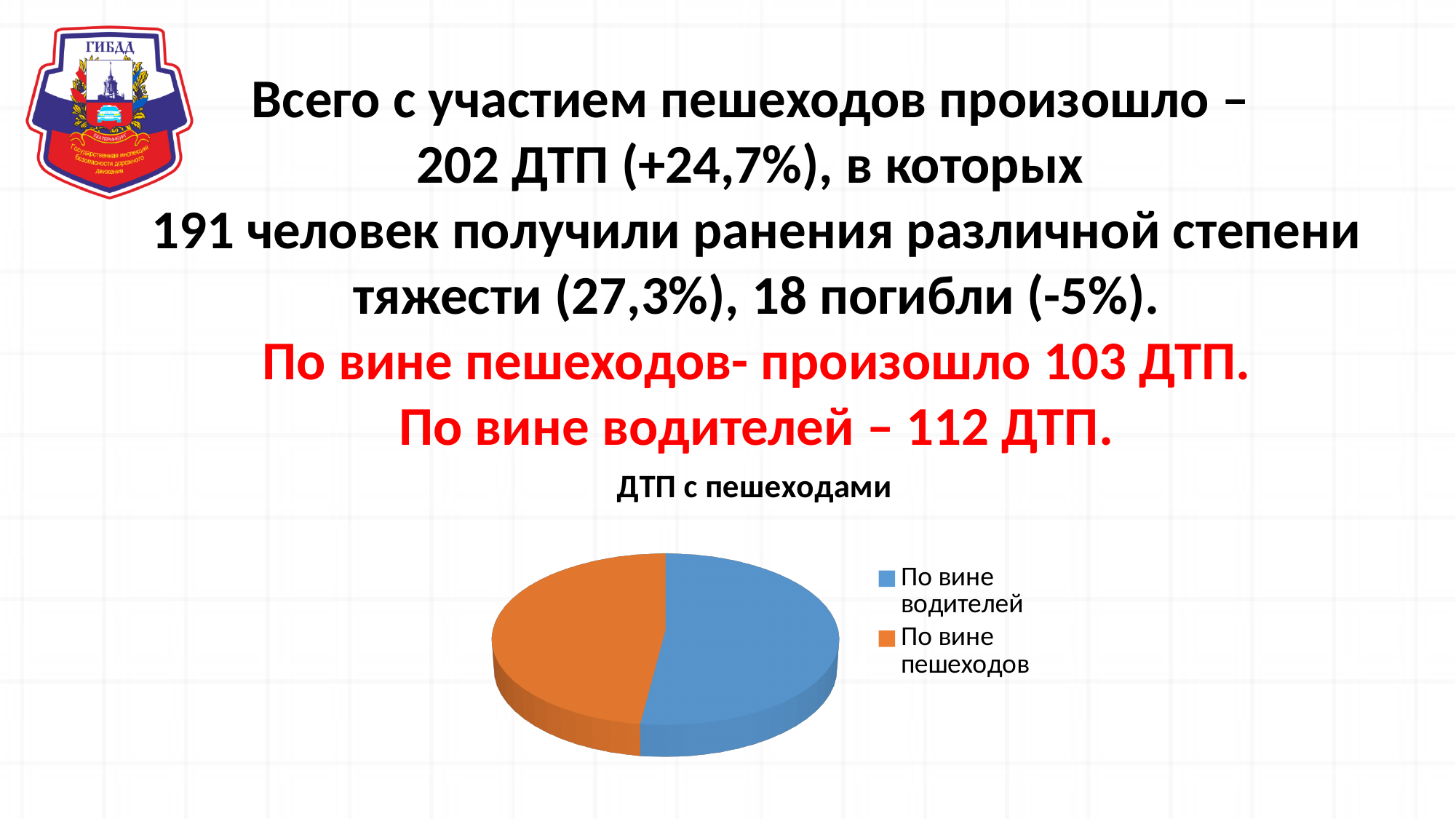
According to the slide, how many ДТП were caused by drivers (По вине водителей)? 112 Which category in the pie chart has the highest value? По вине водителей What is the title of the chart on the slide? ДТП с пешеходами What is the total number of ДТП represented by the two slices of the pie chart? 215 Which slice of the pie chart is larger: "По вине водителей" or "По вине пешеходов"? По вине водителей Which colour represents "По вине водителей" in the pie chart? blue What is the difference between the number of ДТП caused by drivers and the number caused by pedestrians? 9 What kind of chart is shown on the slide? pie chart How many entries does the chart legend list? 2 How many slices does the pie chart have? 2 Which category in the pie chart has the lowest value? По вине пешеходов According to the slide, how many ДТП were caused by pedestrians (По вине пешеходов)? 103